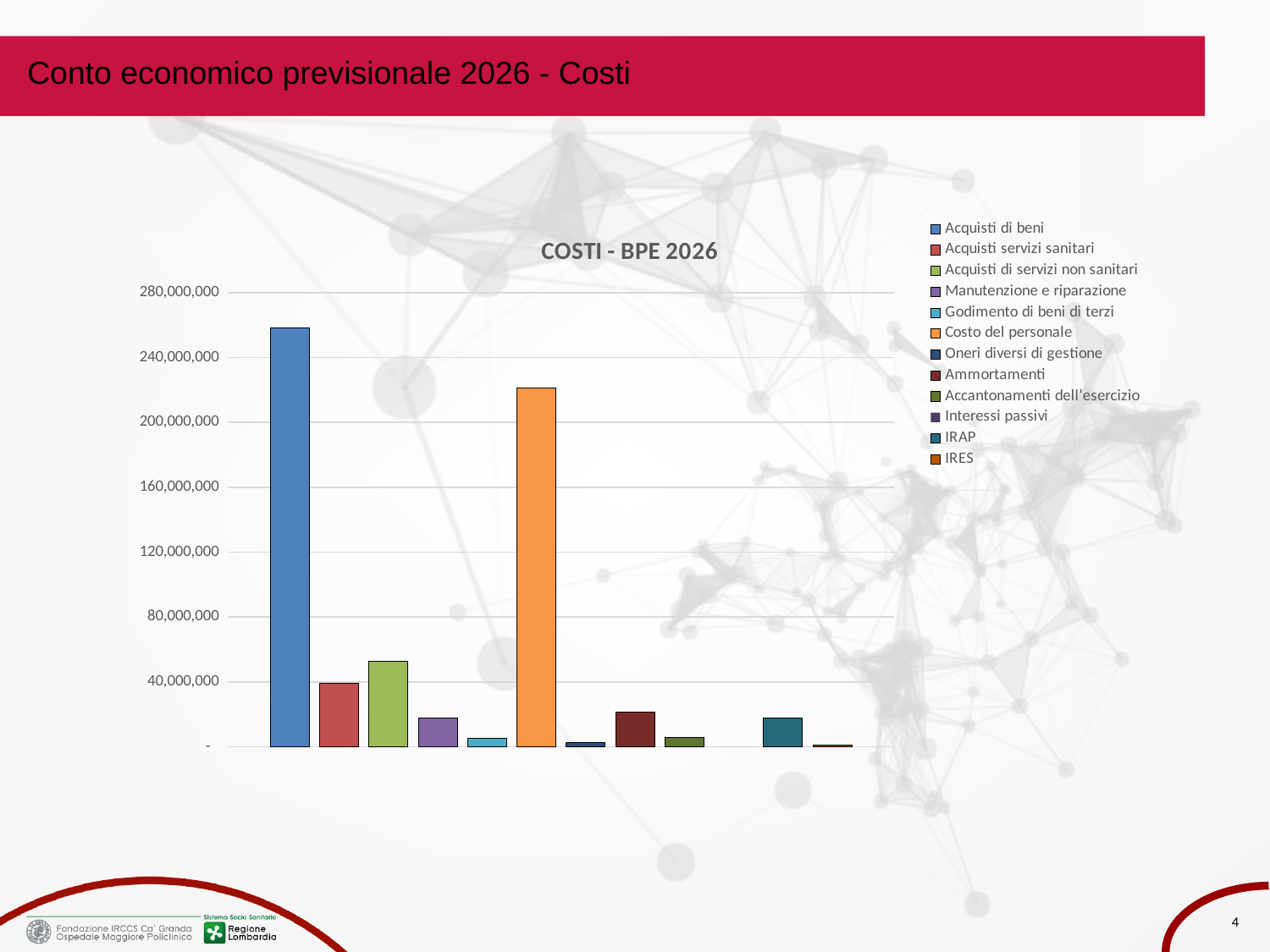
What kind of chart is shown on the slide? bar chart Is the value for Acquisti di servizi non sanitari greater or less than 40,000,000? greater Which cost category has the highest bar in the chart? Acquisti di beni Is the value for Ammortamenti greater or less than 40,000,000? less Is the value for Costo del personale greater or less than 200,000,000? greater Which is larger, Acquisti di servizi non sanitari or Acquisti servizi sanitari? Acquisti di servizi non sanitari Which is larger, Acquisti di beni or Costo del personale? Acquisti di beni What is the highest value shown on the vertical axis of the chart? 280,000,000 How many series does the legend of the chart list? 12 What is the title of the chart? COSTI - BPE 2026